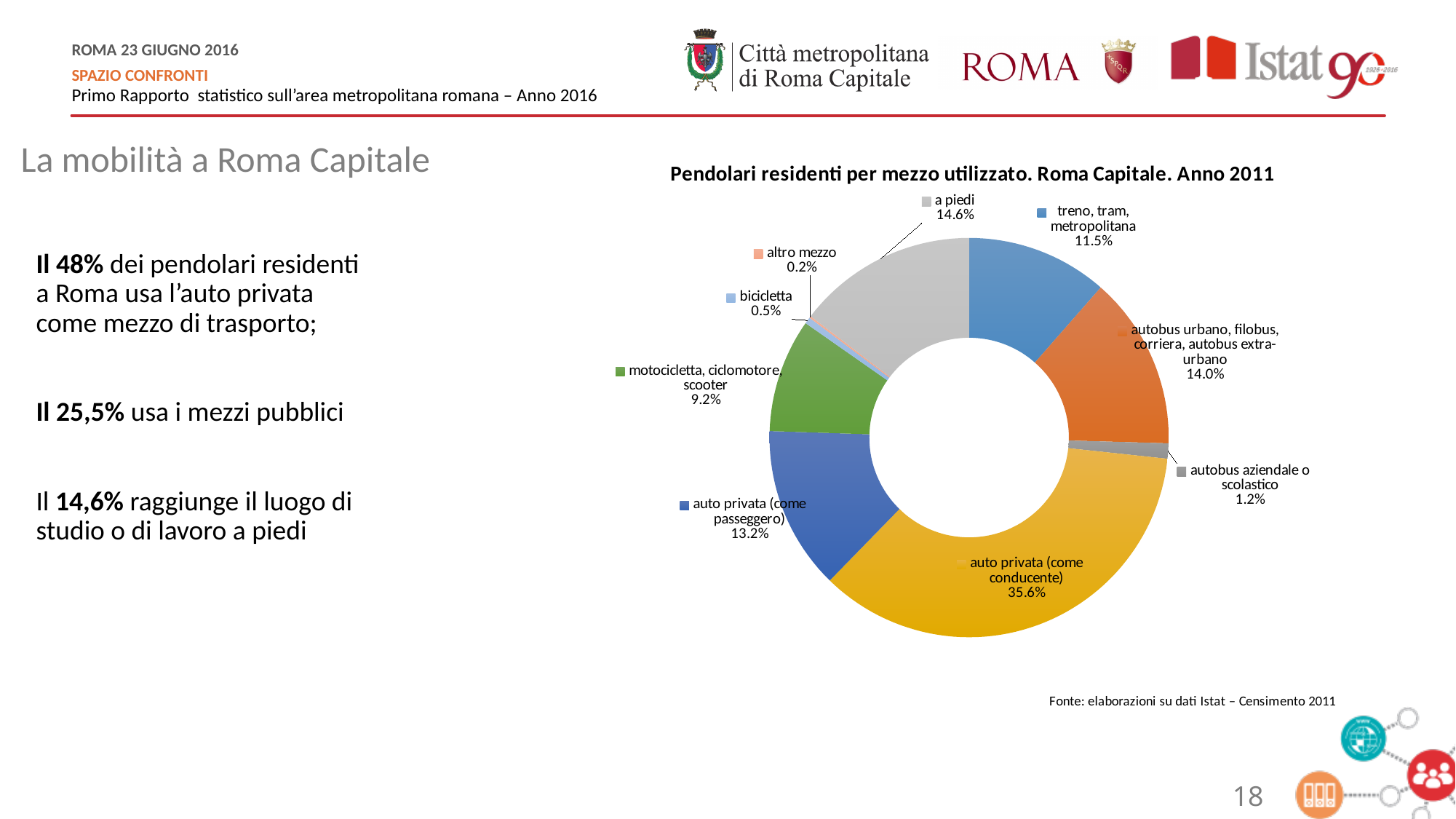
How many categories are shown in the chart? 9 What share of commuters use 'auto privata (come conducente)'? 35.6% What is the combined share of 'bicicletta' and 'altro mezzo'? 0.7% What is the value for 'a piedi'? 14.6% What is the difference between 'auto privata (come conducente)' and 'auto privata (come passeggero)'? 22.4 percentage points Which category has the smallest share in the chart? altro mezzo What percentage is shown for 'treno, tram, metropolitana'? 11.5% What kind of chart is shown on the slide? Doughnut (pie) chart Which category has the largest share in the chart? auto privata (come conducente) Which is larger: 'autobus urbano, filobus, corriera, autobus extra-urbano' or 'treno, tram, metropolitana'? autobus urbano, filobus, corriera, autobus extra-urbano What is the value for 'motocicletta, ciclomotore, scooter'? 9.2% What is the title of the chart? Pendolari residenti per mezzo utilizzato. Roma Capitale. Anno 2011